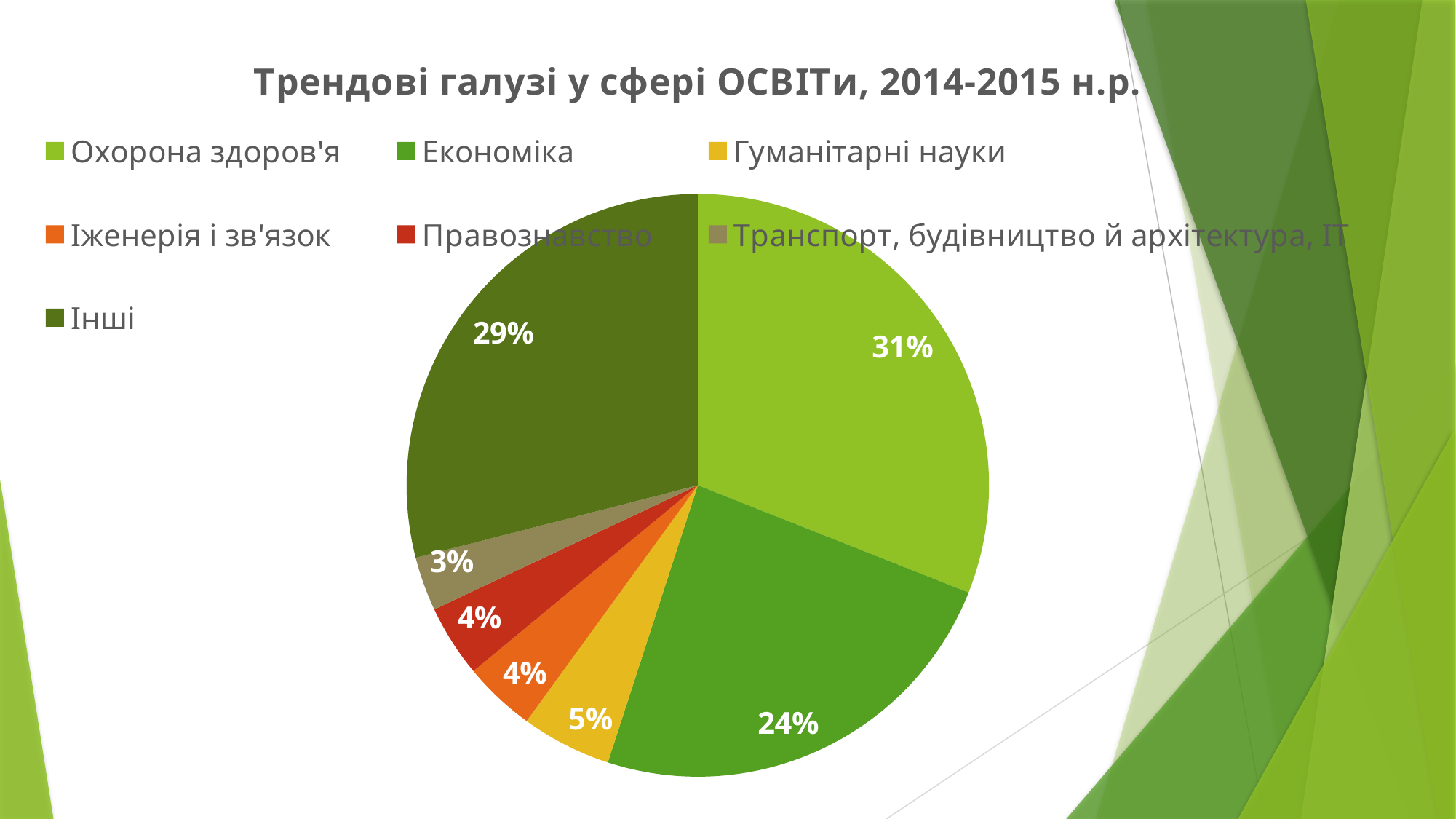
Which category has the smallest share of the pie? Транспорт, будівництво й архітектура, ІТ What is the difference in percentage points between Охорона здоров'я and Економіка? 7 What share of the pie does Інші have? 29% Which category has the largest share of the pie? Охорона здоров'я What share of the pie does Економіка have? 24% What type of chart is shown on the slide? Pie chart Which is larger, the share for Інші or the share for Економіка? Інші What share of the pie does Гуманітарні науки have? 5% How many slices does the pie chart have? 7 What is the title of the chart? Трендові галузі у сфері ОСВІТи, 2014-2015 н.р.